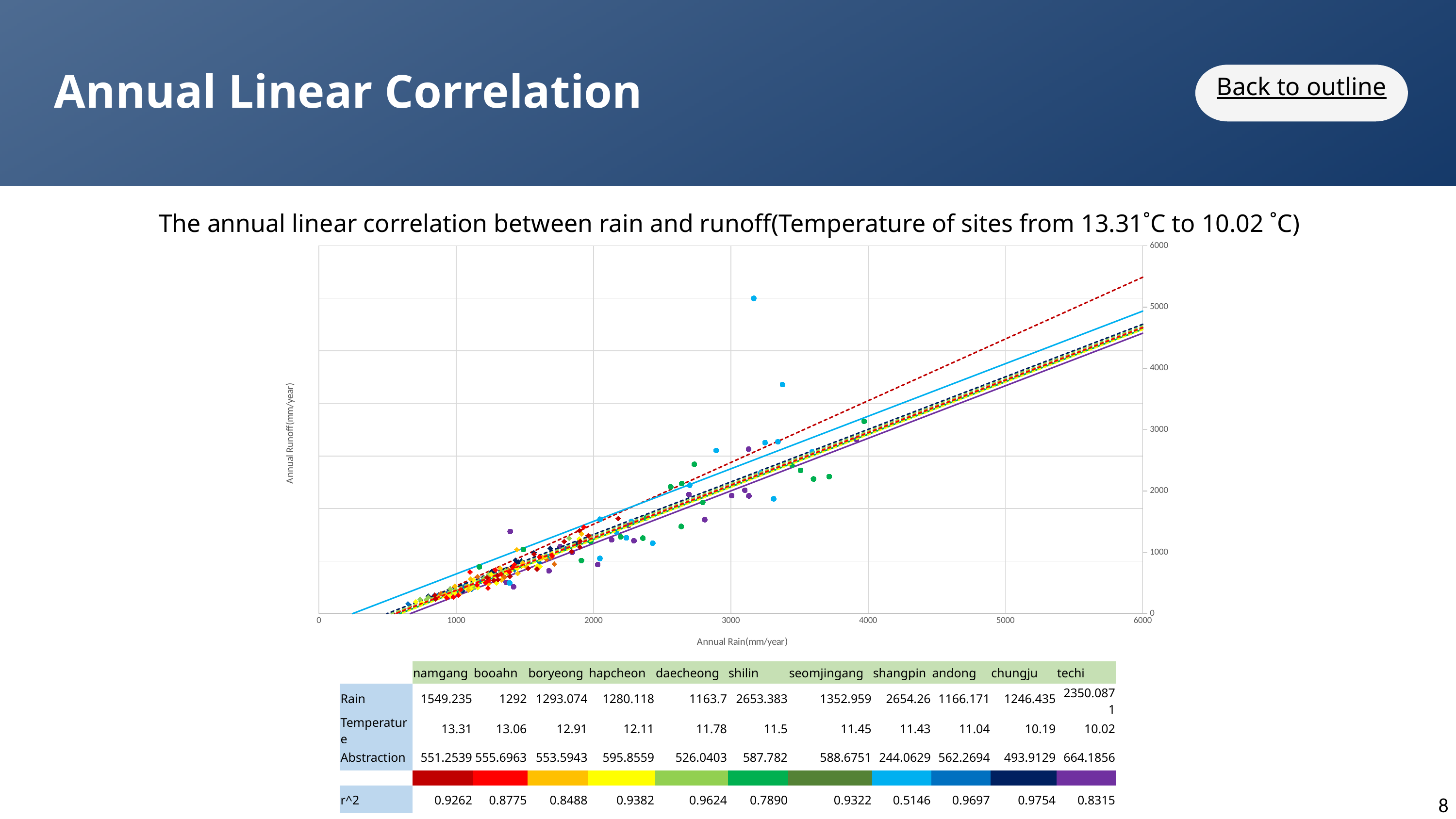
Which site has the lowest r^2 value in the table below the chart? shangpin At an annual rain of 6000, is the purple trend line greater or less than 5000 on the runoff axis? less What is the title of the x axis of the chart? Annual Rain(mm/year) Which site has the highest r^2 value in the table below the chart? chungju How many sites are listed in the table below the chart? 11 What is the maximum value shown on the x axis of the chart? 6000 What kind of chart is shown on the slide? scatter chart What is the title of the y axis of the chart? Annual Runoff(mm/year) Is the annual runoff of the highest plotted point in the chart greater or less than 4000? greater What is the r^2 value for shangpin in the table below the chart? 0.5146 At an annual rain of 6000, is the red dashed trend line greater or less than 5000 on the runoff axis? greater What is the Rain value for shilin in the table below the chart? 2653.383